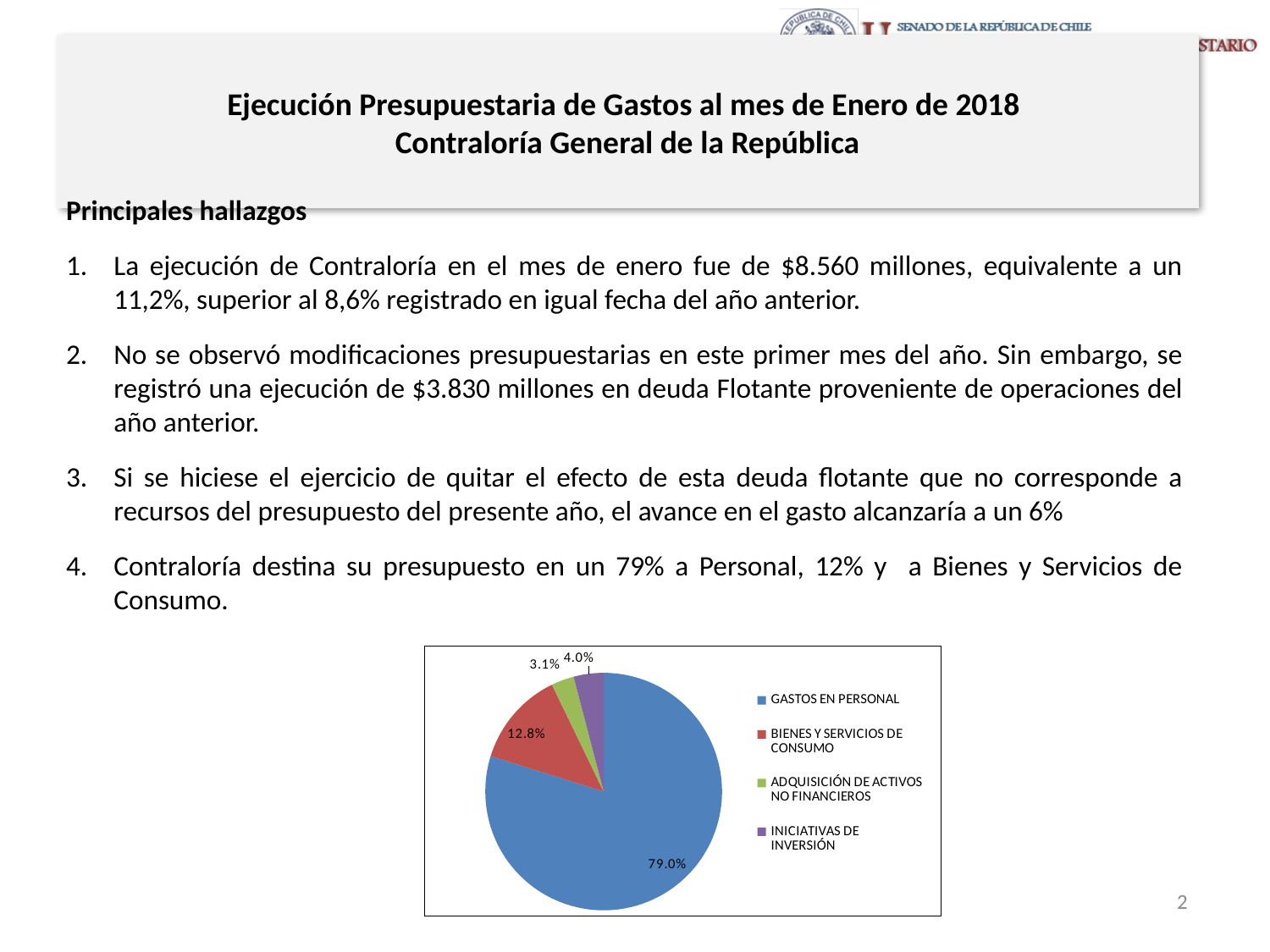
What is the difference in percentage points between GASTOS EN PERSONAL and BIENES Y SERVICIOS DE CONSUMO? 66.2 What kind of chart is shown on the slide? pie chart Which is larger, the slice for INICIATIVAS DE INVERSIÓN or the slice for ADQUISICIÓN DE ACTIVOS NO FINANCIEROS? INICIATIVAS DE INVERSIÓN Which category has the smallest slice of the pie? ADQUISICIÓN DE ACTIVOS NO FINANCIEROS What share of the pie does GASTOS EN PERSONAL represent? 79.0% What colour is the slice for GASTOS EN PERSONAL? blue What colour is the slice for BIENES Y SERVICIOS DE CONSUMO? red What share of the pie does ADQUISICIÓN DE ACTIVOS NO FINANCIEROS represent? 3.1% What share of the pie does INICIATIVAS DE INVERSIÓN represent? 4.0% Which category has the largest slice of the pie? GASTOS EN PERSONAL What share of the pie does BIENES Y SERVICIOS DE CONSUMO represent? 12.8% How many categories does the pie chart show? 4